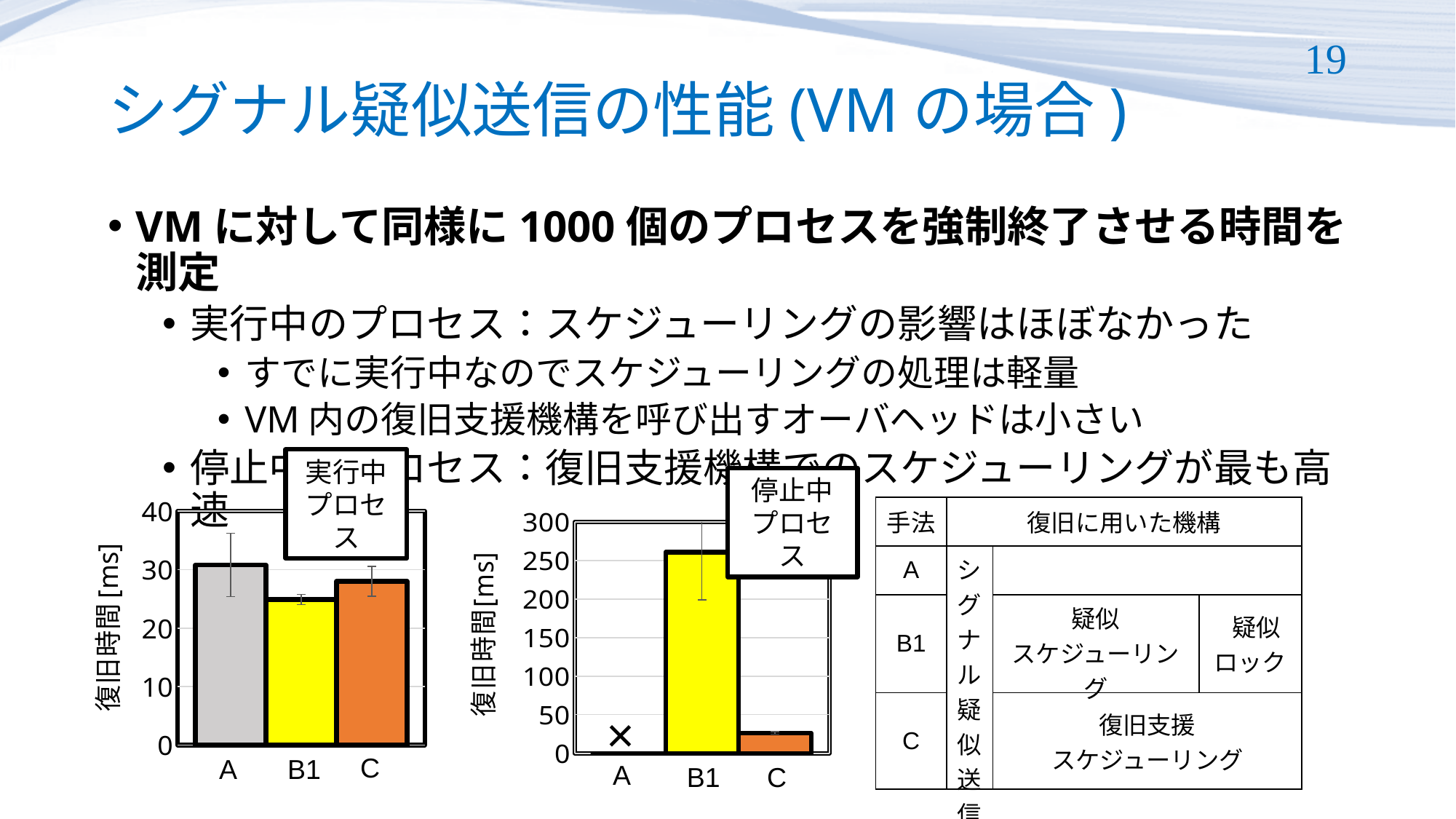
In the left chart (実行中プロセス), which category has the highest recovery time? A In the left chart (実行中プロセス), is the value for B1 greater or less than 30? less What is the y-axis label of the left chart (実行中プロセス)? 復旧時間 [ms] In the left chart (実行中プロセス), is the value for A greater or less than 20? greater In the right chart (停止中プロセス), is the value for C greater or less than 50? less In the left chart (実行中プロセス), which is larger, the value for A or the value for B1? A How many categories are shown on the x axis of the left chart (実行中プロセス)? 3 In the left chart (実行中プロセス), which category has the lowest recovery time? B1 In the right chart (停止中プロセス), which is larger, the value for B1 or the value for C? B1 What kind of chart is the left chart labelled 実行中プロセス? bar chart In the right chart (停止中プロセス), which category has the highest recovery time? B1